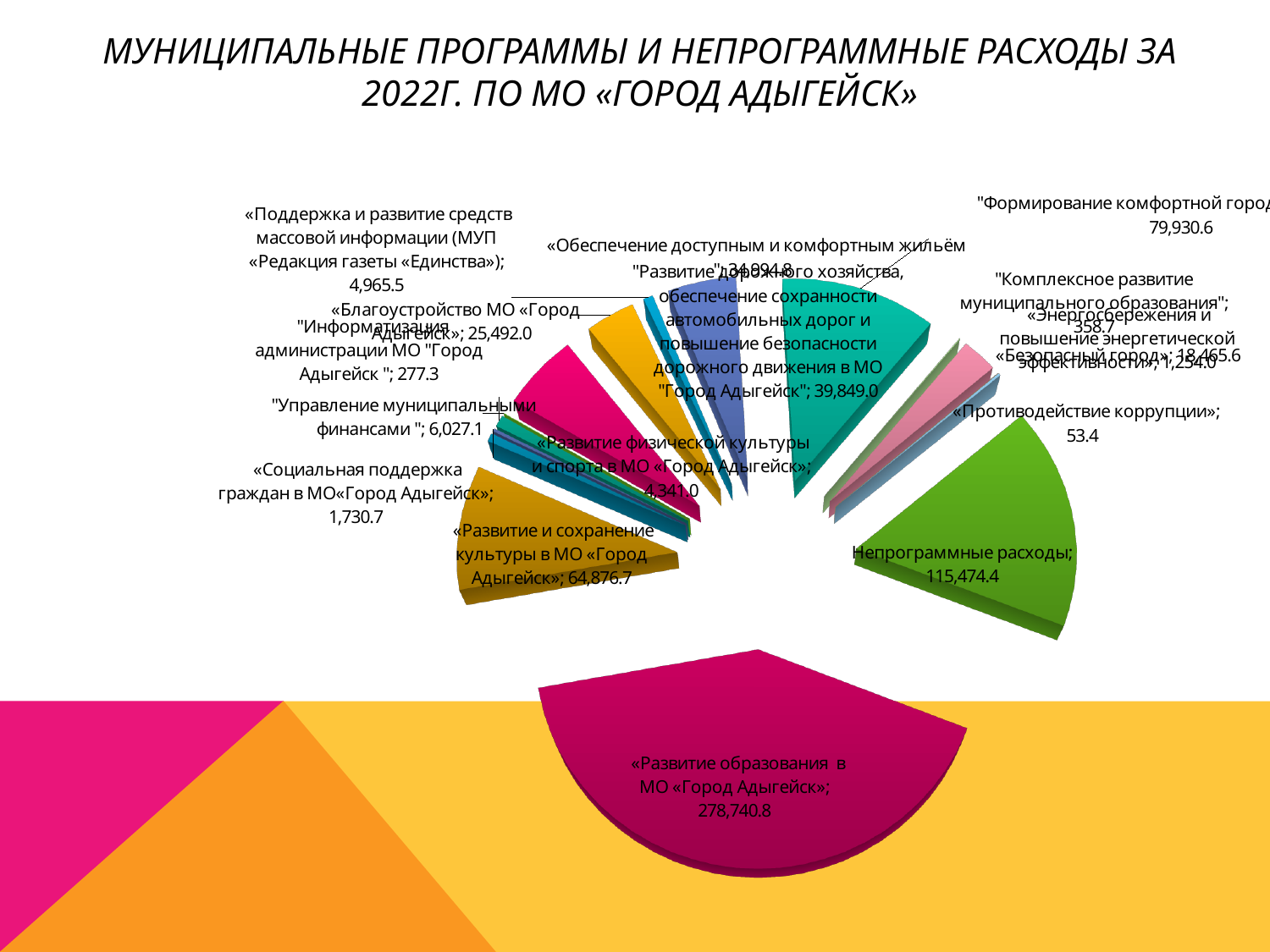
What is the value for Непрограммные расходы? 115,474.4 What is the value for «Благоустройство МО «Город Адыгейск»? 25,492.0 What kind of chart is shown on the slide? pie chart What is the value for «Развитие и сохранение культуры в МО «Город Адыгейск»? 64,876.7 What is the value for «Развитие образования в МО «Город Адыгейск»? 278,740.8 Which is larger: «Социальная поддержка граждан в МО«Город Адыгейск» or "Управление муниципальными финансами"? "Управление муниципальными финансами" What is the difference between «Развитие образования в МО «Город Адыгейск» and Непрограммные расходы? 163,266.4 Which category has the largest value? «Развитие образования в МО «Город Адыгейск» What is the value for "Управление муниципальными финансами"? 6,027.1 What is the title of the slide? МУНИЦИПАЛЬНЫЕ ПРОГРАММЫ И НЕПРОГРАММНЫЕ РАСХОДЫ ЗА 2022Г. ПО МО «ГОРОД АДЫГЕЙСК» Which category has the smallest value? «Противодействие коррупции» What is the value for «Противодействие коррупции»? 53.4